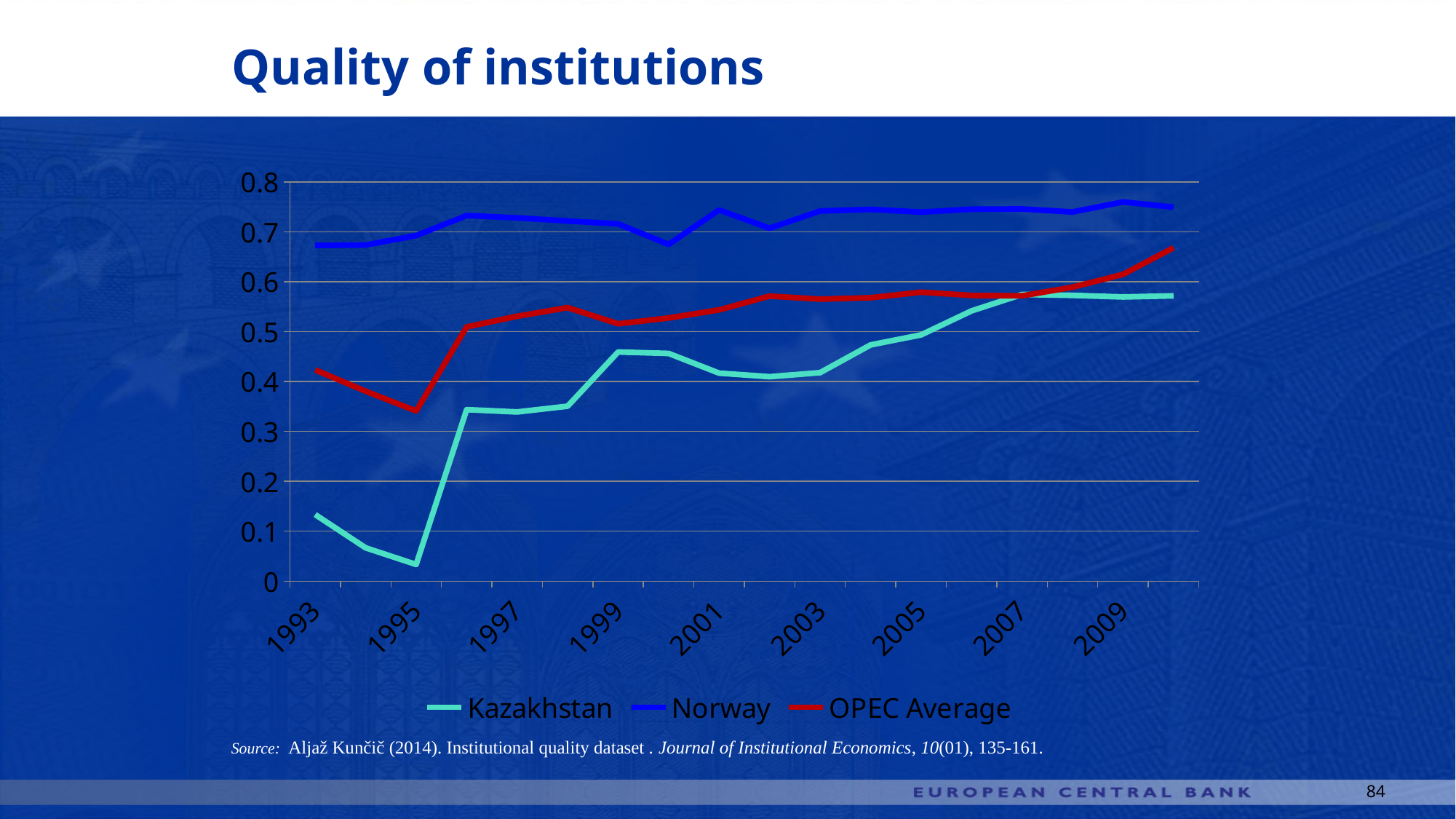
Which series has the lowest value in 1993? Kazakhstan Which series are listed in the legend? Kazakhstan, Norway, OPEC Average How many year labels are shown on the x axis? 9 Is the value for Kazakhstan in 2009 greater or less than 0.6? less In 2005, which is larger: the value for Kazakhstan or the value for OPEC Average? OPEC Average What kind of chart is shown on the slide? line chart What is the title of the slide containing the chart? Quality of institutions Is the value for OPEC Average in 1995 greater or less than 0.4? less Is the value for Kazakhstan in 1995 greater or less than 0.1? less How many series does the legend list? 3 Which series has the highest value in 1999? Norway